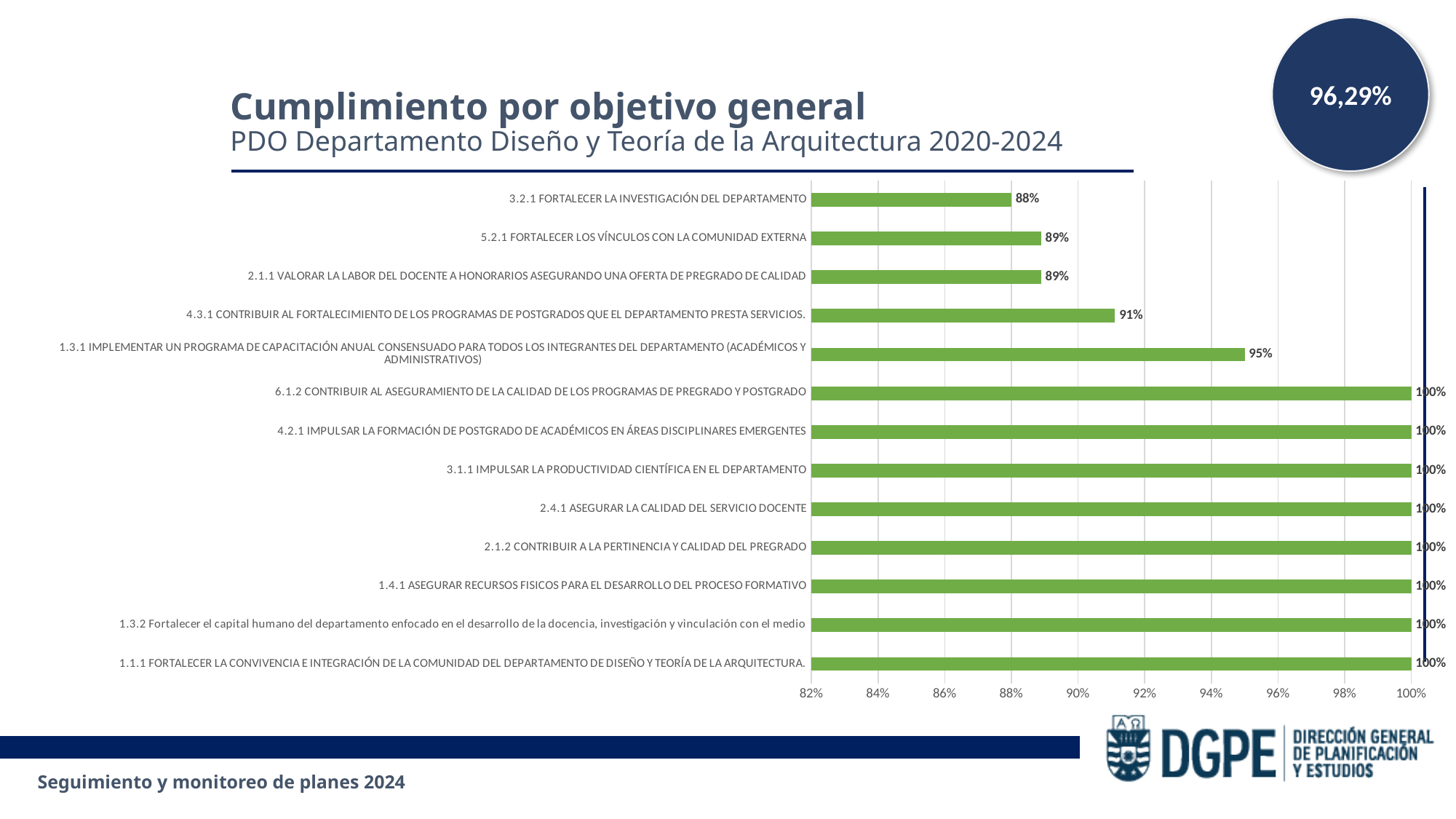
What is the value for 1.3.1 IMPLEMENTAR UN PROGRAMA DE CAPACITACIÓN ANUAL CONSENSUADO PARA TODOS LOS INTEGRANTES DEL DEPARTAMENTO (ACADÉMICOS Y ADMINISTRATIVOS)? 95% Which is larger: the value for 4.3.1 CONTRIBUIR AL FORTALECIMIENTO DE LOS PROGRAMAS DE POSTGRADOS or the value for 5.2.1 FORTALECER LOS VÍNCULOS CON LA COMUNIDAD EXTERNA? 4.3.1 CONTRIBUIR AL FORTALECIMIENTO DE LOS PROGRAMAS DE POSTGRADOS What is the value for 5.2.1 FORTALECER LOS VÍNCULOS CON LA COMUNIDAD EXTERNA? 89% What is the value for 4.3.1 CONTRIBUIR AL FORTALECIMIENTO DE LOS PROGRAMAS DE POSTGRADOS QUE EL DEPARTAMENTO PRESTA SERVICIOS.? 91% Is the value for 1.3.1 IMPLEMENTAR UN PROGRAMA DE CAPACITACIÓN ANUAL greater or less than 94%? greater How many objectives are shown in the chart? 13 What is the difference between the value for 1.3.1 IMPLEMENTAR UN PROGRAMA DE CAPACITACIÓN ANUAL and the value for 3.2.1 FORTALECER LA INVESTIGACIÓN DEL DEPARTAMENTO? 7 percentage points What kind of chart is shown on the slide? Bar chart What is the value for 3.2.1 FORTALECER LA INVESTIGACIÓN DEL DEPARTAMENTO? 88% How many objectives have a value of 100%? 8 What is the title of the chart on the slide? Cumplimiento por objetivo general Which objective has the lowest value in the chart? 3.2.1 FORTALECER LA INVESTIGACIÓN DEL DEPARTAMENTO